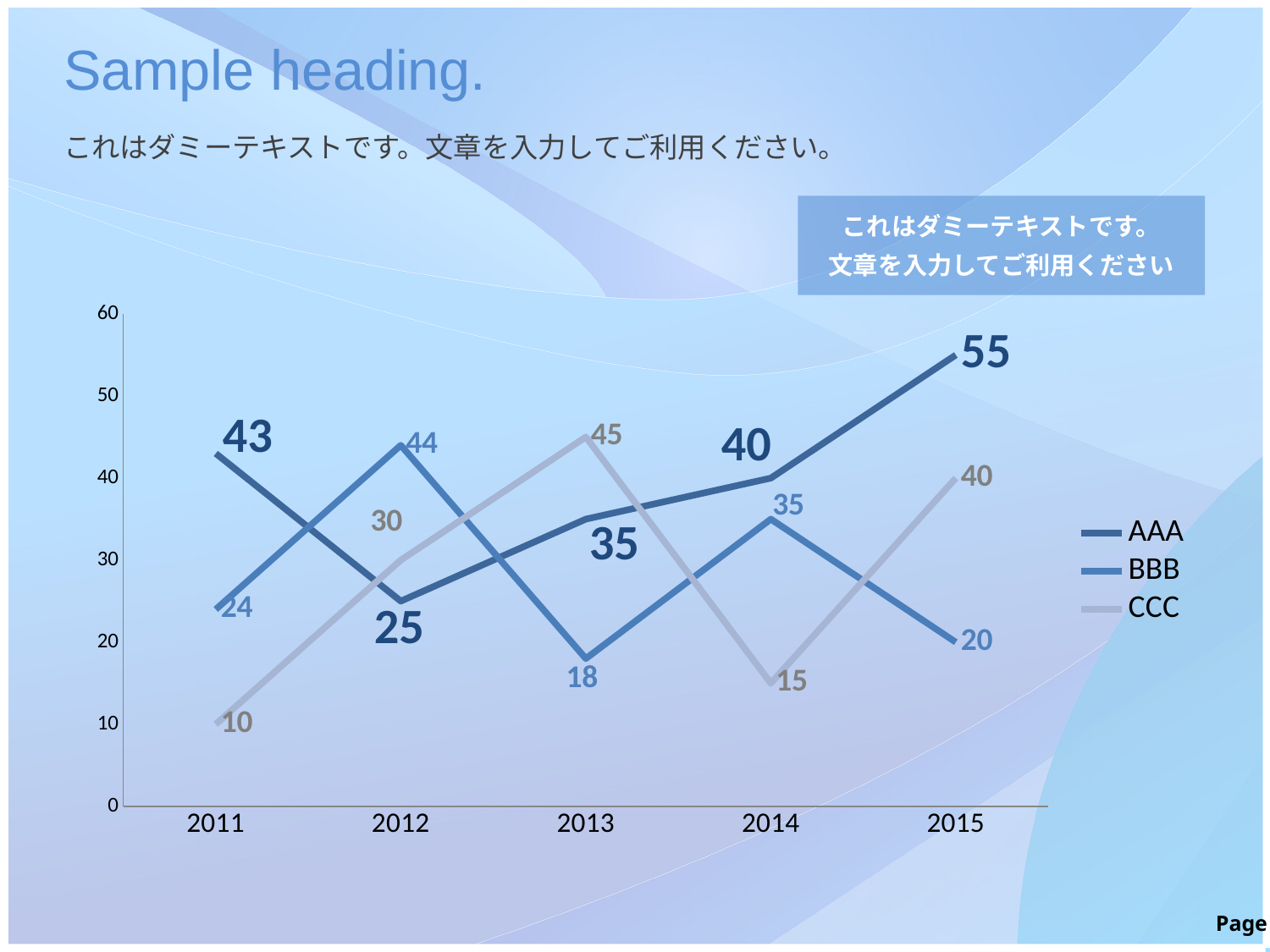
In which year is BBB at its highest? 2012 Does AAA rise or fall from 2012 to 2015? rise What is the value of AAA in 2015? 55 What is the value of BBB in 2013? 18 What kind of chart is this? line chart Which is larger in 2013, AAA or CCC? CCC How many series does the legend list? 3 What is the value of CCC in 2011? 10 In which year is AAA at its lowest? 2012 How many years are shown on the x axis? 5 What is the difference between AAA and BBB in 2014? 5 What is the difference between CCC in 2013 and CCC in 2014? 30